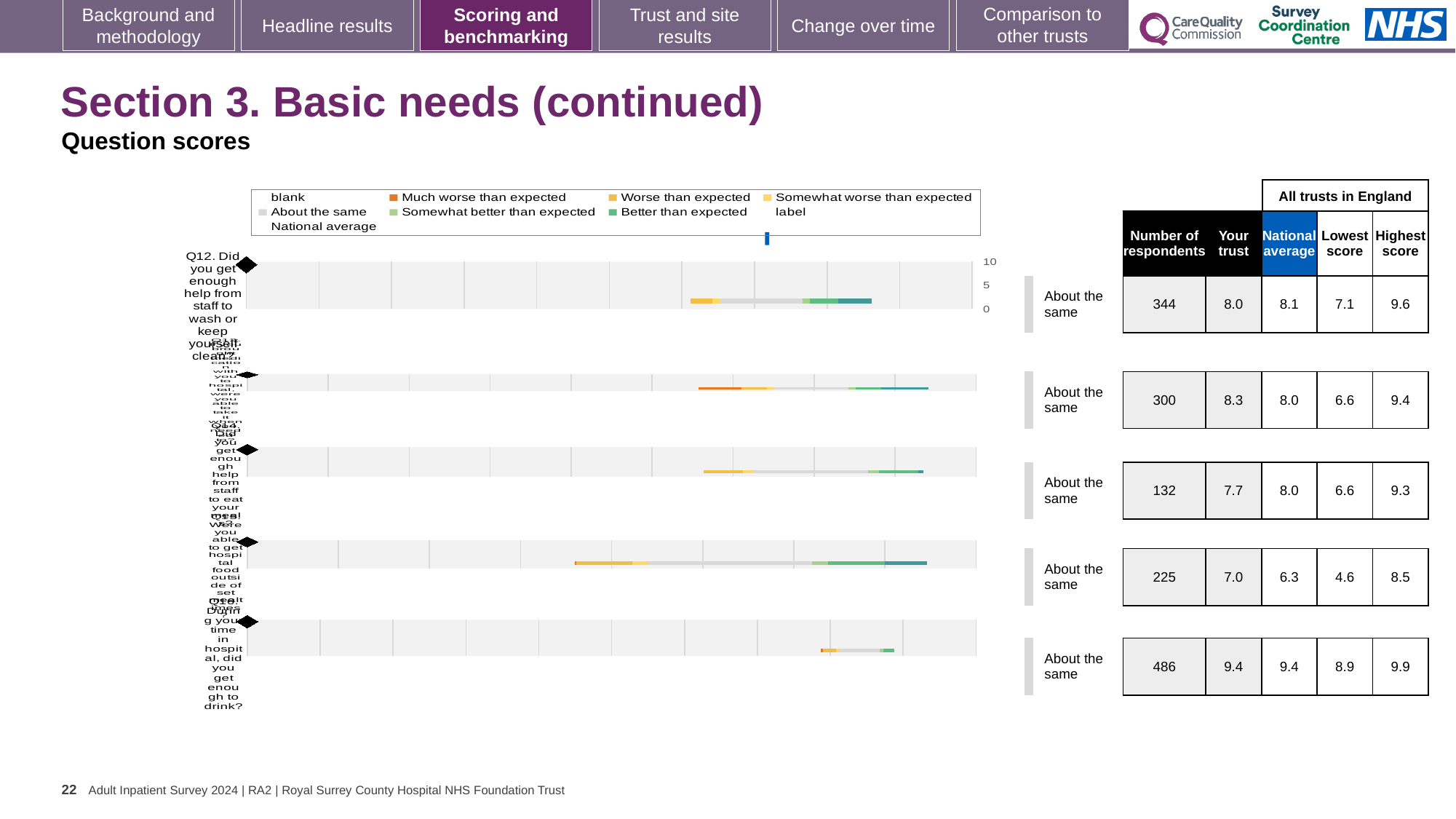
Which row has the lowest 'Your trust' score? the fourth row (225 respondents), 7.0 What is the 'Your trust' score for Q12 (Did you get enough help from staff to wash or keep yourself clean?)? 8.0 Which row has the highest 'Your trust' score? the bottom row (486 respondents), 9.4 What is the difference between the highest score (9.6) and the lowest score (7.1) for Q12? 2.5 What is the national average score for Q12 (help from staff to wash or keep yourself clean)? 8.1 What kind of chart is used to show the question scores on this slide? bar chart How many questions (rows) are plotted in the chart? 5 What colour does the legend use for 'Much worse than expected'? orange For the second row (300 respondents), which is larger: the 'Your trust' score or the national average? Your trust (8.3 vs 8.0) How many of the five questions are rated 'About the same' compared with other trusts? 5 What is the lowest score across all trusts in England for the fourth row (225 respondents)? 4.6 How many respondents answered Q12 (help from staff to wash or keep yourself clean)? 344